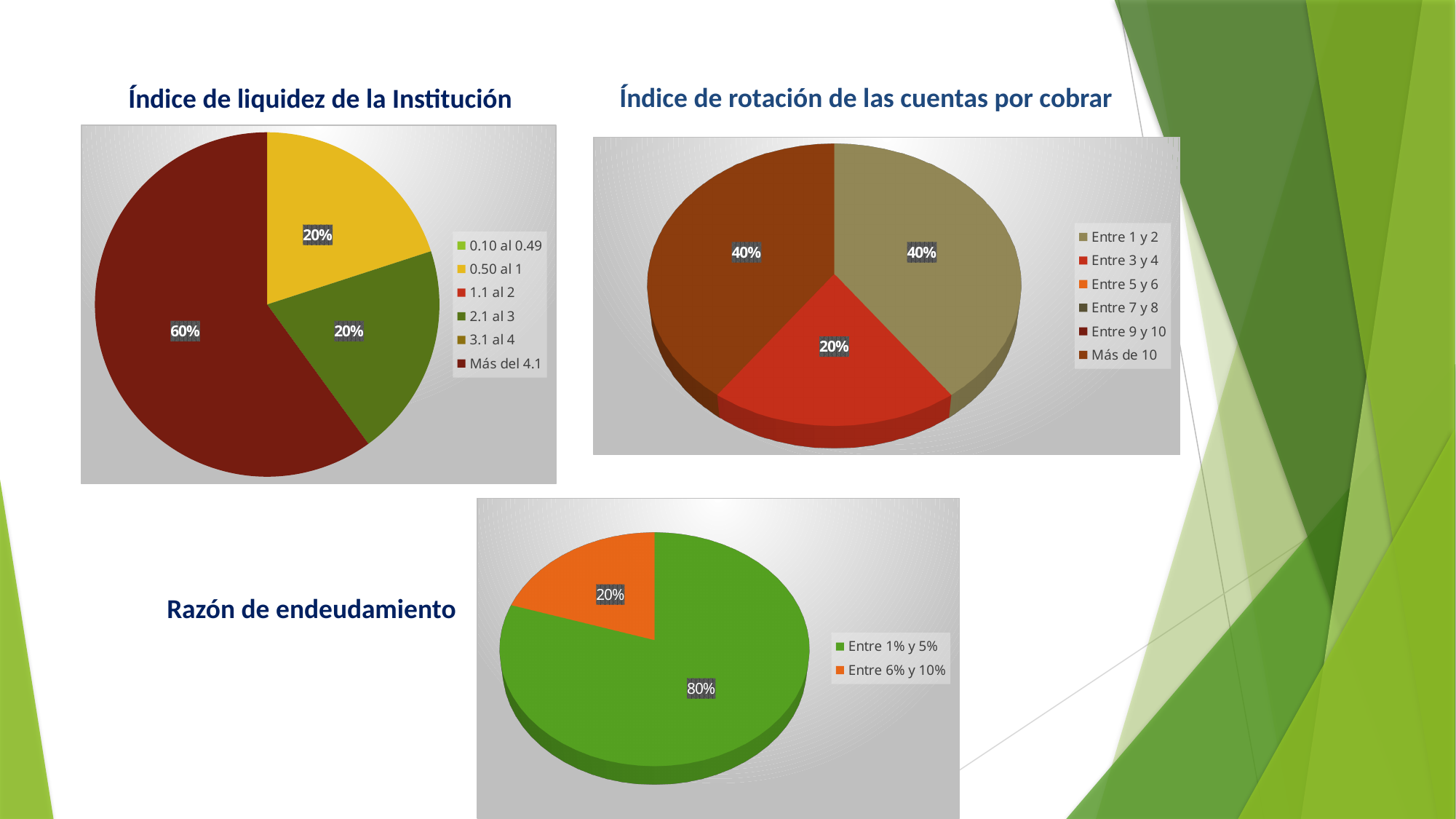
What kind of chart is the one titled "Razón de endeudamiento"? Pie chart In the chart titled "Índice de liquidez de la Institución", what share does the "0.50 al 1" slice have? 20% In the chart titled "Índice de rotación de las cuentas por cobrar", what is the difference between the "Entre 1 y 2" slice and the "Entre 3 y 4" slice? 20% In the chart titled "Razón de endeudamiento", which category has the smallest slice? Entre 6% y 10% In the chart titled "Índice de liquidez de la Institución", which category has the largest slice? Más del 4.1 In the chart titled "Índice de rotación de las cuentas por cobrar", what share does the "Entre 3 y 4" slice have? 20% In the chart titled "Índice de rotación de las cuentas por cobrar", what share does the "Más de 10" slice have? 40% In the chart titled "Índice de liquidez de la Institución", how many entries does the legend list? 6 In the chart titled "Razón de endeudamiento", how many entries does the legend list? 2 In the chart titled "Índice de rotación de las cuentas por cobrar", which is larger, the "Entre 1 y 2" slice or the "Entre 3 y 4" slice? Entre 1 y 2